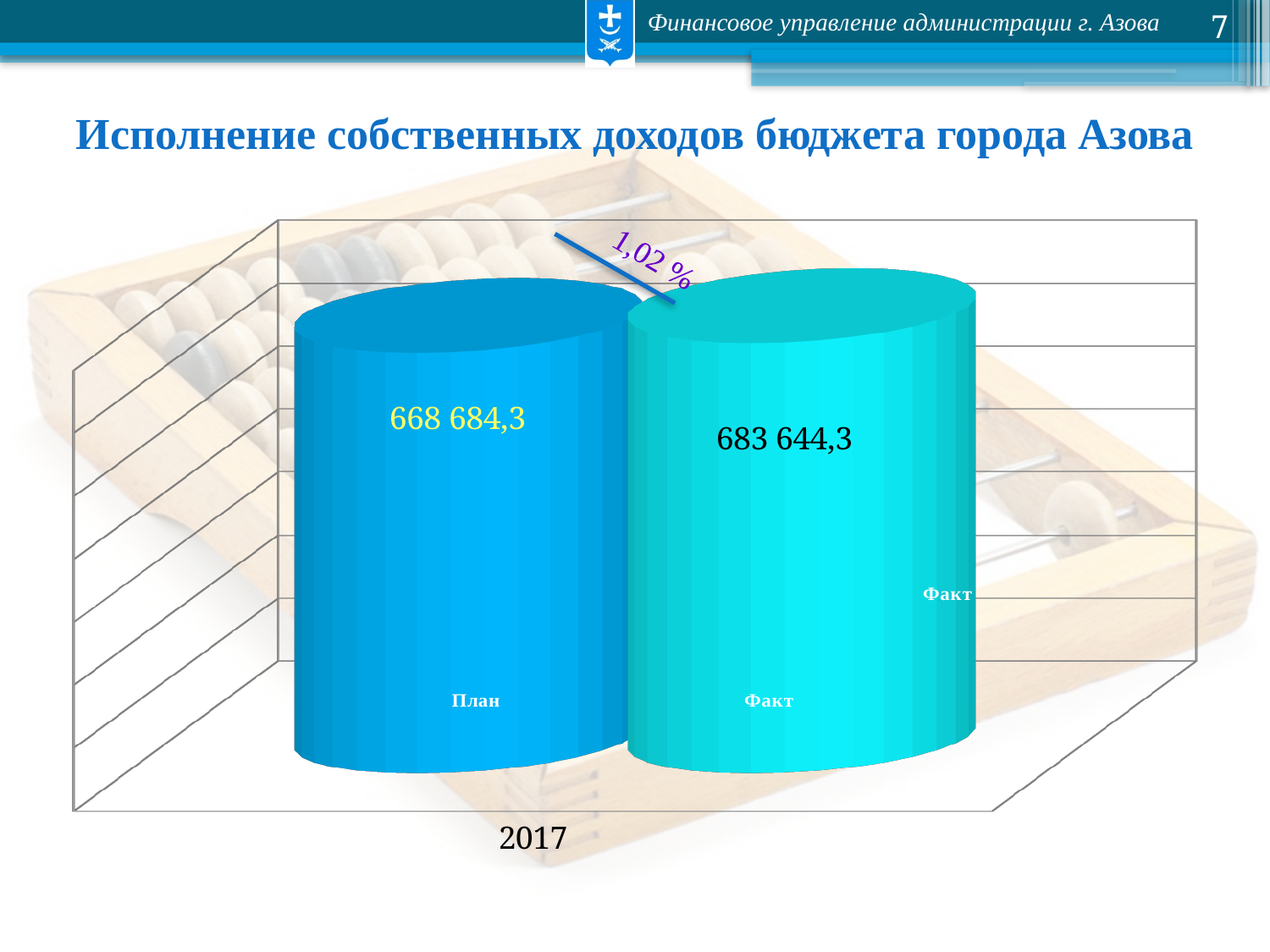
What percentage is written in the annotation above the bars? 1,02 % How many bars are plotted on the chart? 2 What kind of chart is shown on the slide? bar chart What year is shown on the x axis of the chart? 2017 What is the value of the Факт bar? 683 644,3 What is the difference between the Факт value and the План value? 14 960,0 What is the value of the План bar? 668 684,3 Which bar has the lowest value? План Which bar is higher, План or Факт? Факт Is the Факт value larger or smaller than the План value? larger